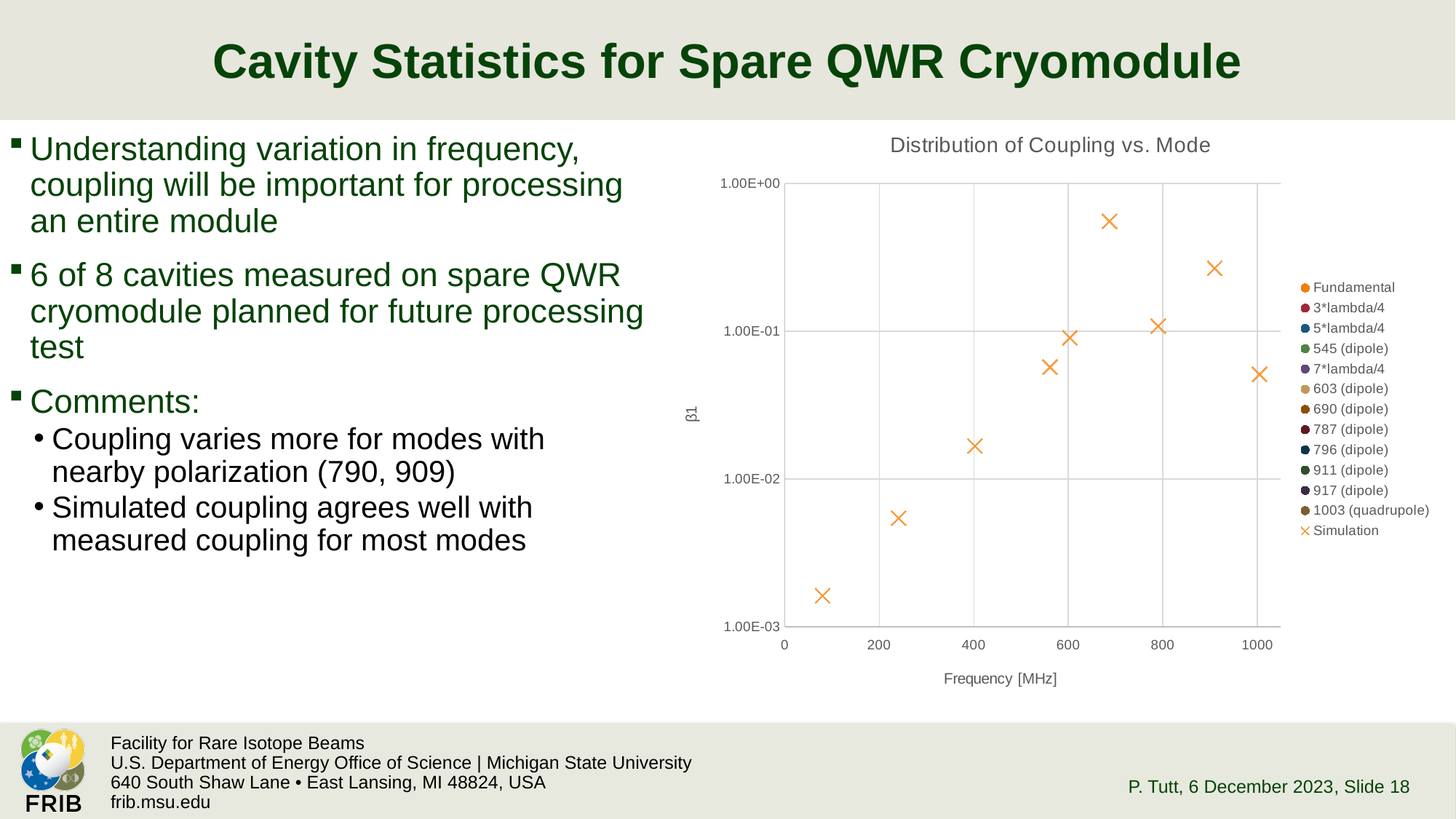
What is the label of the x axis of the chart? Frequency [MHz] Is the Simulation value for the point near 1000 MHz greater or less than 1.00E-01? less Is the Simulation value for the point near 80 MHz greater or less than 1.00E-02? less What kind of chart is shown on the slide? scatter chart How many Simulation points are plotted on the chart? 9 Is the Simulation value for the point near 400 MHz greater or less than 1.00E-02? greater Which of the two Simulation points, the one near 80 MHz or the one near 400 MHz, has the lower β1 value? the one near 80 MHz How many entries does the chart's legend list? 13 Which of the two Simulation points, the one near 690 MHz or the one near 910 MHz, has the higher β1 value? the one near 690 MHz What is the title of the chart? Distribution of Coupling vs. Mode